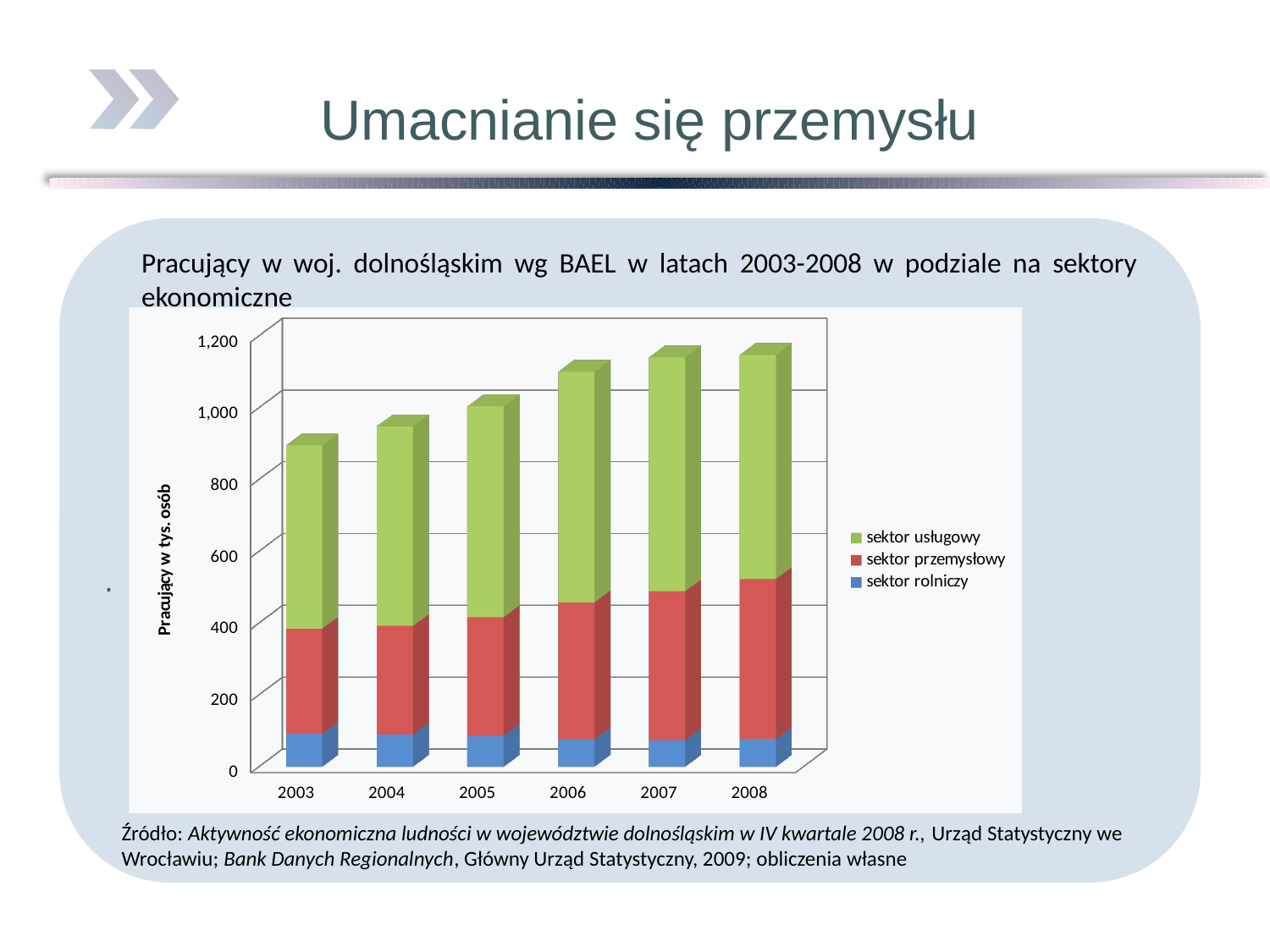
What kind of chart is shown on the slide? Stacked bar chart Is the total value for 2004 greater or less than 1,000? less Is the total value for 2003 greater or less than 1,000? less Which year has the lowest total number of employed persons in the chart? 2003 Is the total value for 2008 greater or less than 1,000? greater What is the label of the vertical axis of the chart? Pracujący w tys. osób How many years are shown on the x axis of the chart? 6 How many series does the chart legend list? 3 Which is larger, the total for 2006 or the total for 2004? 2006 Do the total values rise or fall from 2003 to 2008? rise Which colour represents 'sektor rolniczy' in the chart? Blue